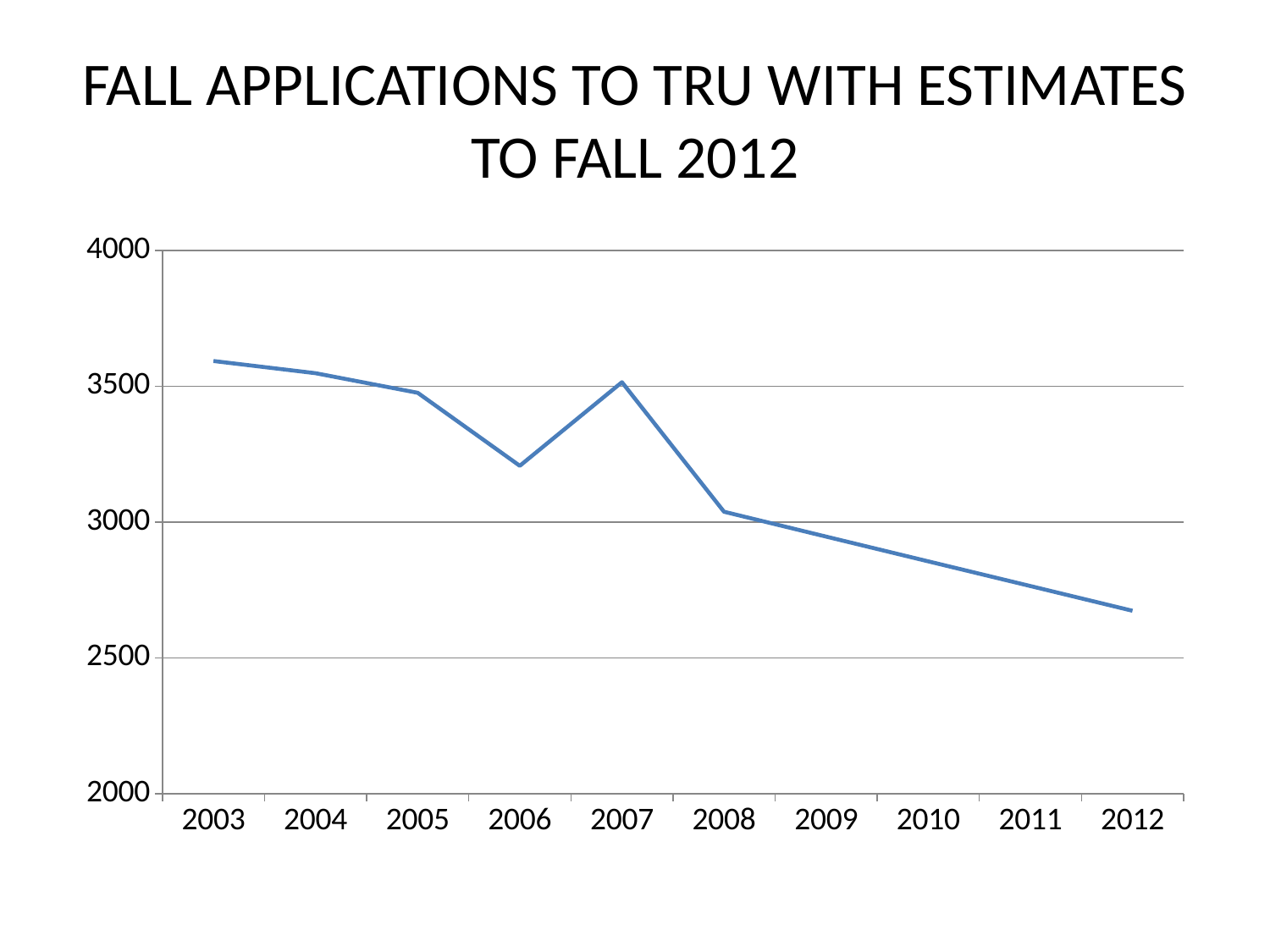
Which year has the highest number of fall applications? 2003 Overall, do the values rise or fall from 2003 to 2012? fall Is the value for 2009 greater or less than 3000? less What kind of chart is shown on the slide? line chart Is the value for 2003 greater or less than 3500? greater Is the value for 2012 greater or less than 2500? greater Which year has the lowest number of fall applications? 2012 Which year has the larger value, 2006 or 2007? 2007 What is the title of the chart? FALL APPLICATIONS TO TRU WITH ESTIMATES TO FALL 2012 How many years are plotted along the x axis? 10